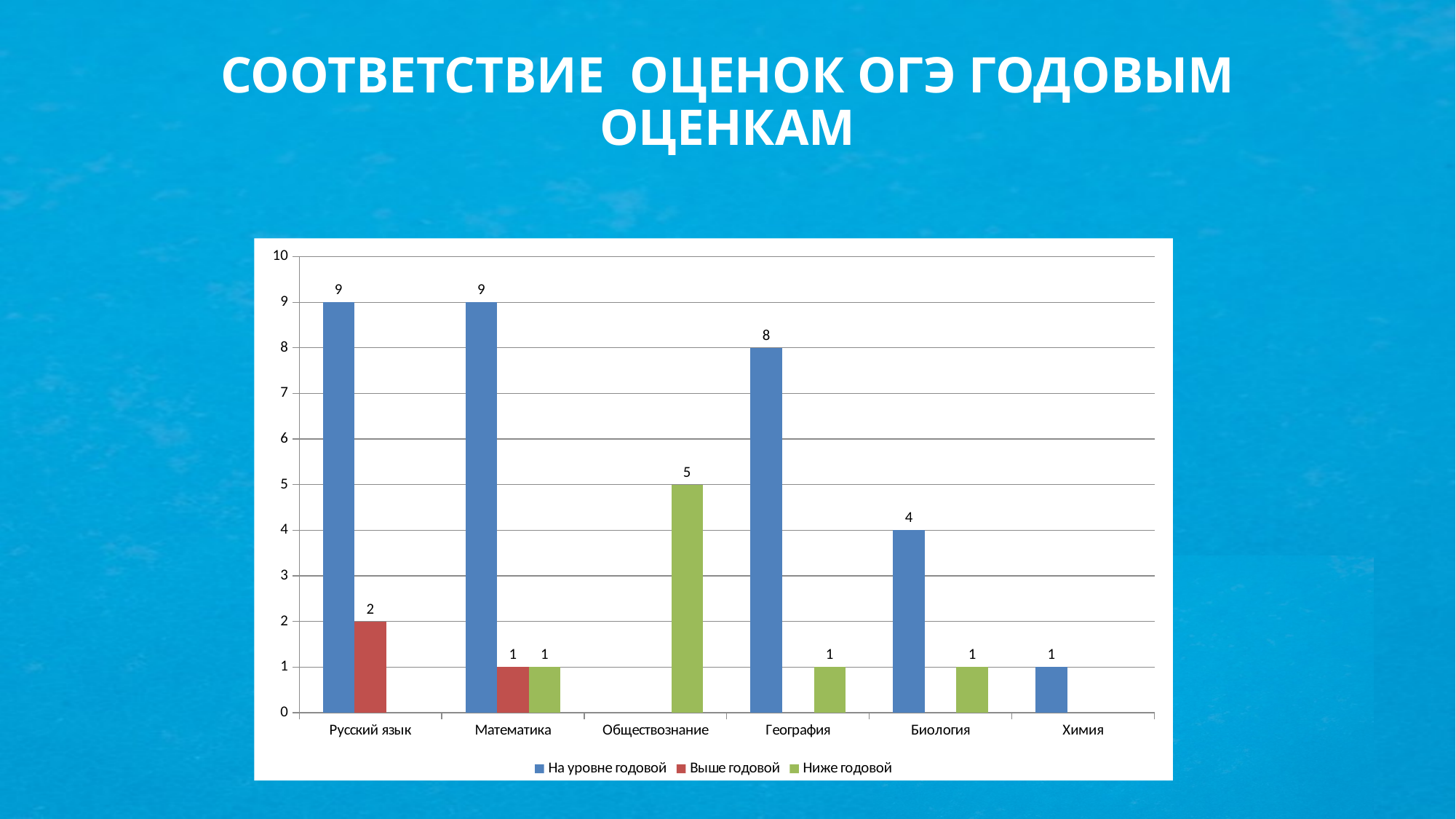
What is the value of "На уровне годовой" for Русский язык? 9 What is the value of "Ниже годовой" for Обществознание? 5 Which is larger: "На уровне годовой" for Математика or for География? Математика What is the value of "На уровне годовой" for Биология? 4 What is the difference between the "На уровне годовой" values for География and Биология? 4 How many categories are shown on the x axis? 6 What is the value of "Выше годовой" for Русский язык? 2 What kind of chart is shown on the slide? Bar chart How many series does the legend list? 3 Which category has the highest value for "Ниже годовой"? Обществознание Which series is shown in red in the legend? Выше годовой Which category has the lowest value for "На уровне годовой"? Химия